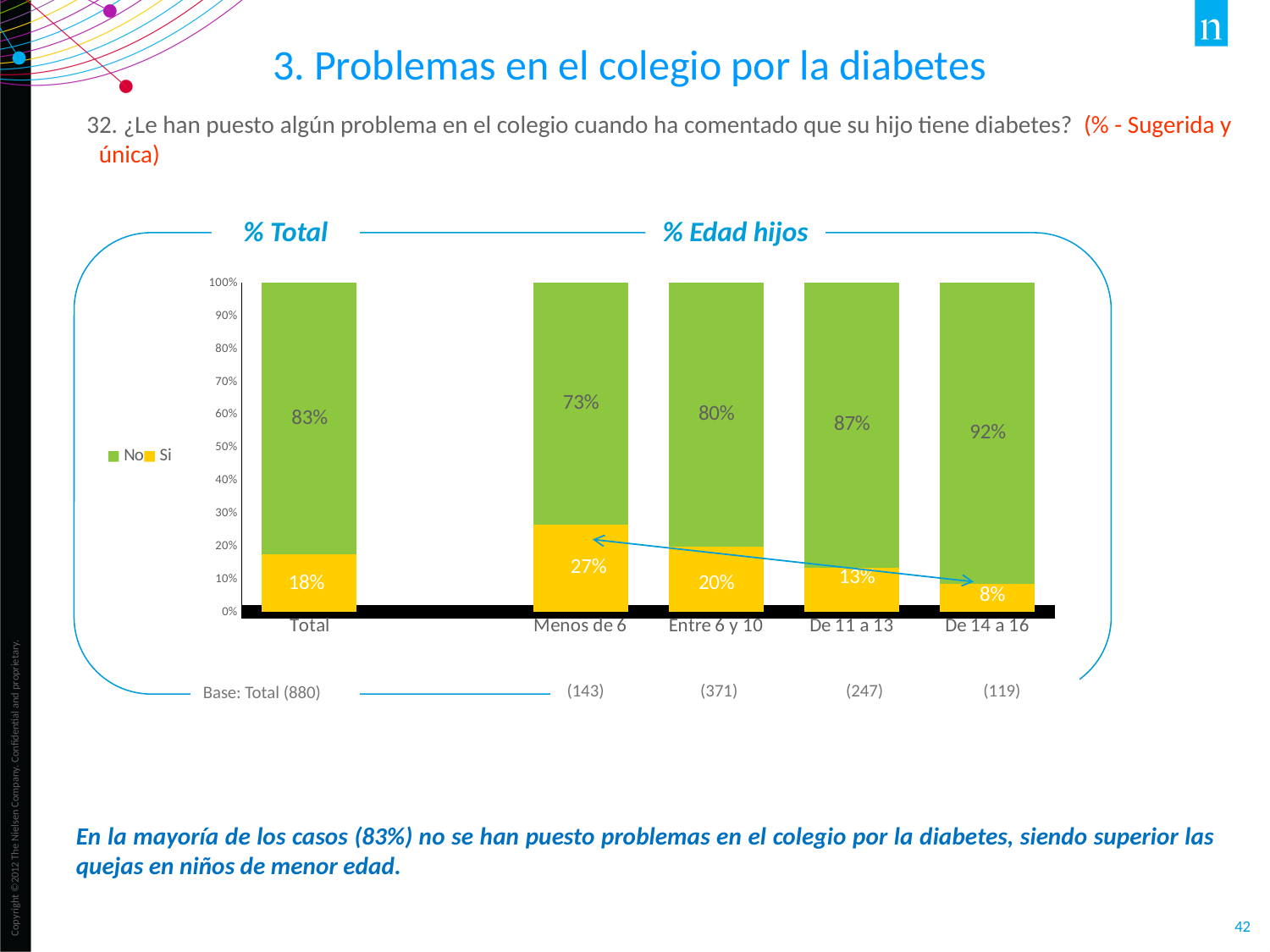
Across the age categories from 'Menos de 6' to 'De 14 a 16', does the 'Si' value rise or fall? Fall What is the 'No' value for the 'Entre 6 y 10' category? 80% What is the 'Si' value for the 'Total' category? 18% Which category has the lowest 'No' value? Menos de 6 Which is larger, the 'No' value for 'De 11 a 13' or for 'Entre 6 y 10'? De 11 a 13 What is the 'No' value for the 'De 14 a 16' category? 92% Which category has the highest 'Si' value? Menos de 6 What is the 'Si' value for the 'Menos de 6' category? 27% What is the difference between the 'Si' values for 'Menos de 6' and 'De 14 a 16'? 19% How many series does the legend list? 2 How many categories are shown on the x axis? 5 What kind of chart is shown on the slide? Stacked bar chart